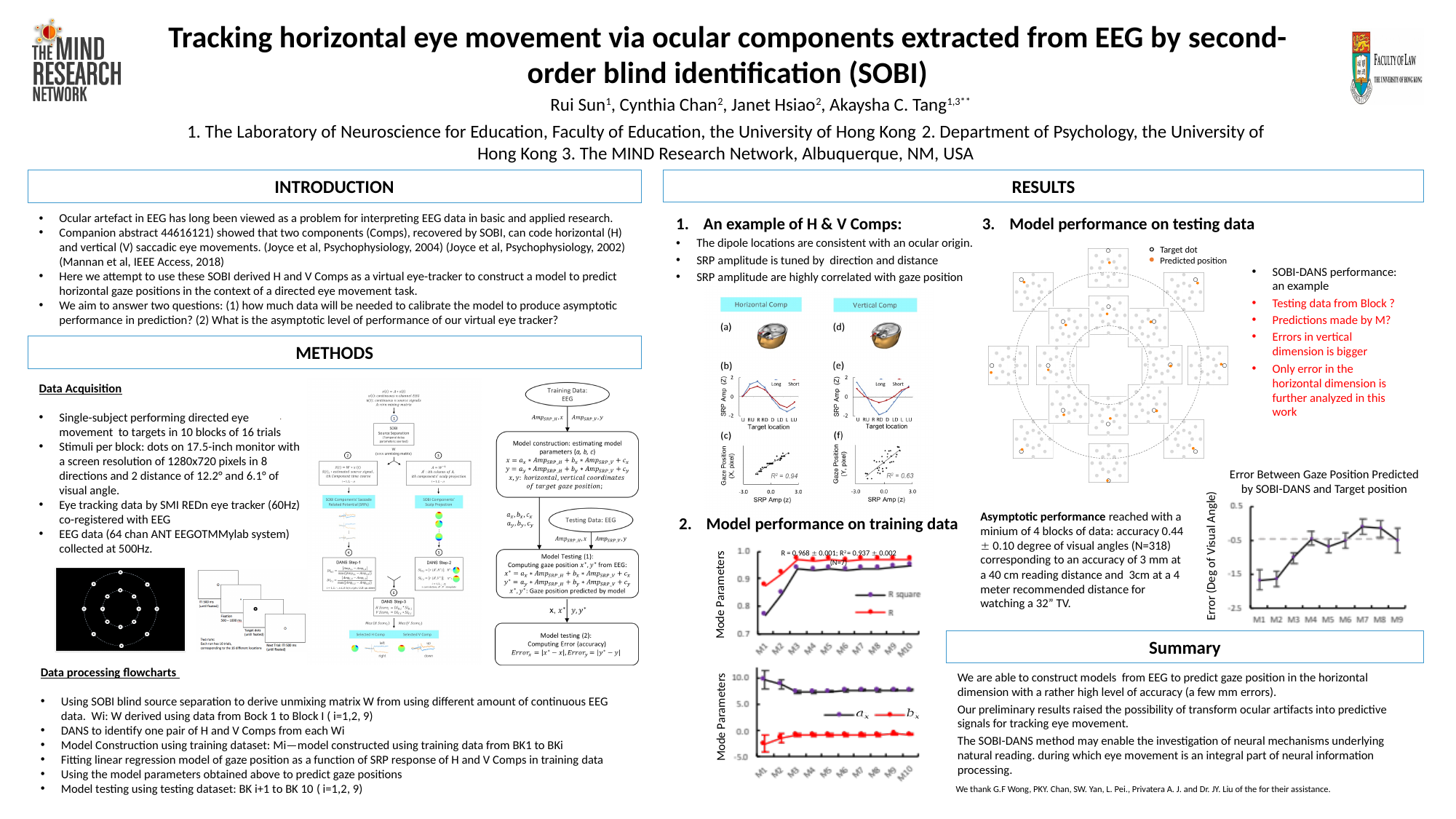
In the 'An example of H & V Comps' section, what R² value is printed on panel (c) for the Horizontal Comp? R² = 0.94 In the upper 'Model performance on training data' chart, what are the two legend entries? R square and R In the 'Error Between Gaze Position Predicted by SOBI-DANS and Target position' chart, is the value for M1 greater or less than -0.5? less In the upper 'Model performance on training data' chart, how many model points (M1 to M10) are plotted along the x axis? 10 In the lower 'Model performance on training data' chart, is the value of a_x at M1 greater or less than 5.0? greater What kind of chart is the 'Error Between Gaze Position Predicted by SOBI-DANS and Target position' chart? line chart In the 'Error Between Gaze Position Predicted by SOBI-DANS and Target position' chart, does the error value rise or fall from M1 to M9? rise In the 'Error Between Gaze Position Predicted by SOBI-DANS and Target position' chart, how many model points (M labels) are plotted along the x axis? 9 In the upper 'Model performance on training data' chart, how many series does the legend list? 2 In the upper 'Model performance on training data' chart, is the R square value at M1 greater or less than 0.8? less In the upper 'Model performance on training data' chart, which series has the larger value at M1, R or R square? R